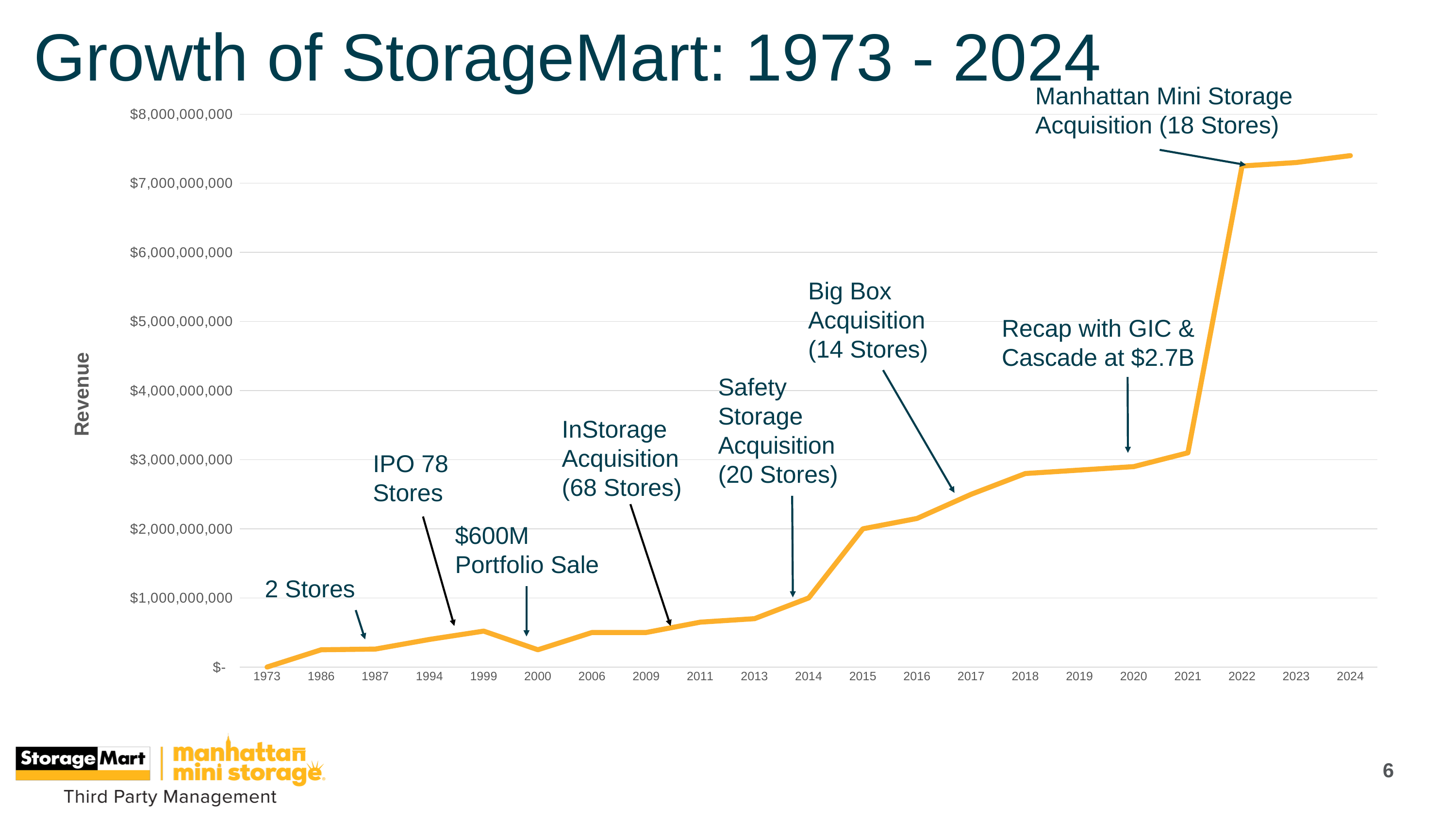
What kind of chart is shown on the slide? line chart What is the label on the vertical axis of the chart? Revenue Is the revenue for 2013 greater or less than $1,000,000,000? less Which year has the lowest revenue on the chart? 1973 Which event is annotated at the 2022 point on the chart? Manhattan Mini Storage Acquisition (18 Stores) Which year has the higher revenue, 1999 or 2000? 1999 Does revenue generally rise or fall from 1973 to 2024? rise Which year has the highest revenue on the chart? 2024 Is the revenue for 2022 greater or less than $7,000,000,000? greater Is the revenue for 2017 greater or less than $2,000,000,000? greater How many years are plotted along the x axis of the chart? 21